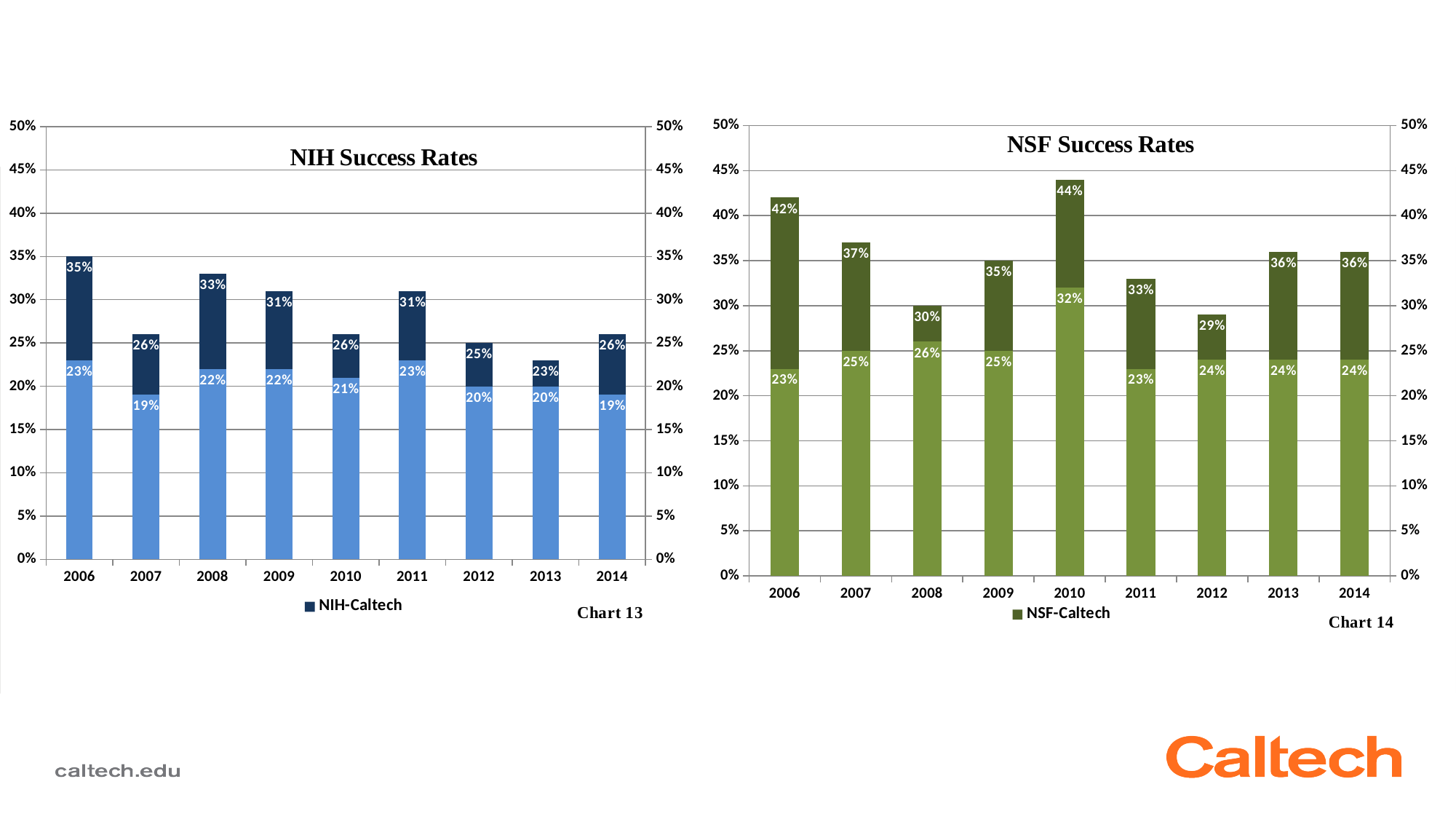
What is the chart number printed below the NSF Success Rates chart? Chart 14 In the NSF Success Rates chart, is the NSF-Caltech value for 2006 greater or less than 40%? greater How many years are shown on the x axis of the NIH Success Rates chart? 9 In the NSF Success Rates chart, what is the difference between the NSF-Caltech success rates for 2010 and 2012? 15 percentage points In the NIH Success Rates chart, which year has the highest NIH-Caltech success rate? 2006 In the NIH Success Rates chart, what is the NIH-Caltech success rate for 2006? 35% In the NIH Success Rates chart, is the NIH-Caltech success rate higher in 2008 or in 2009? 2008 In the NSF Success Rates chart, what is the NSF-Caltech success rate for 2010? 44% In the NSF Success Rates chart, which year has the lowest NSF-Caltech success rate? 2012 In the NSF Success Rates chart, what is the NSF-Caltech success rate for 2008? 30% What kind of chart is the NSF Success Rates chart? bar chart In the NIH Success Rates chart, what is the NIH-Caltech success rate for 2013? 23%